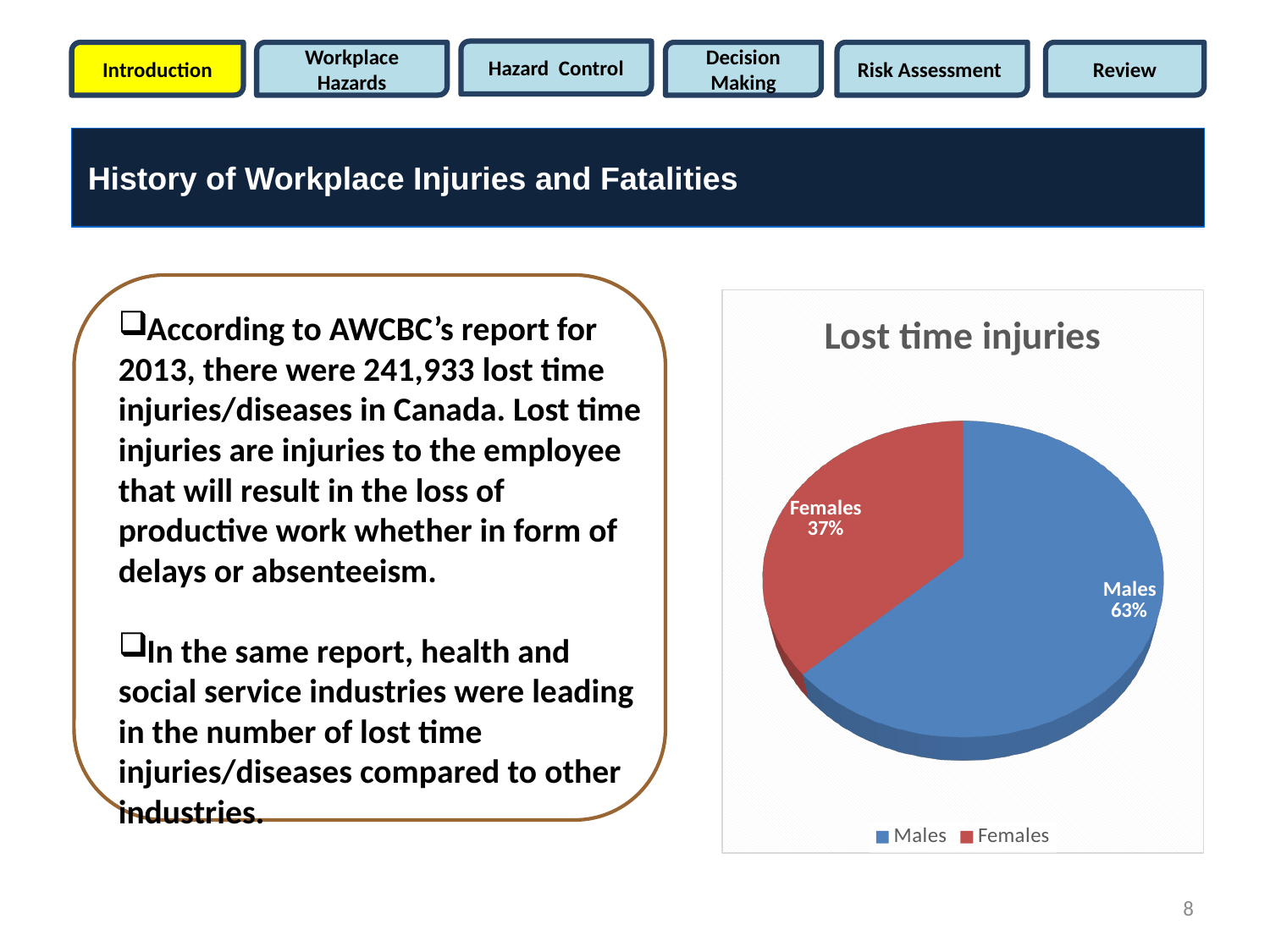
What colour is the Females slice? red Which category has the smallest slice of the pie? Females What share of lost time injuries is attributed to Males? 63% How many slices does the pie chart have? 2 Which category has the largest slice of the pie? Males What kind of chart is shown on the slide? pie chart Which slice is larger, Males or Females? Males How many entries does the legend list? 2 What is the title of the chart? Lost time injuries What share of lost time injuries is attributed to Females? 37% What is the difference in percentage points between the Males and Females slices? 26%